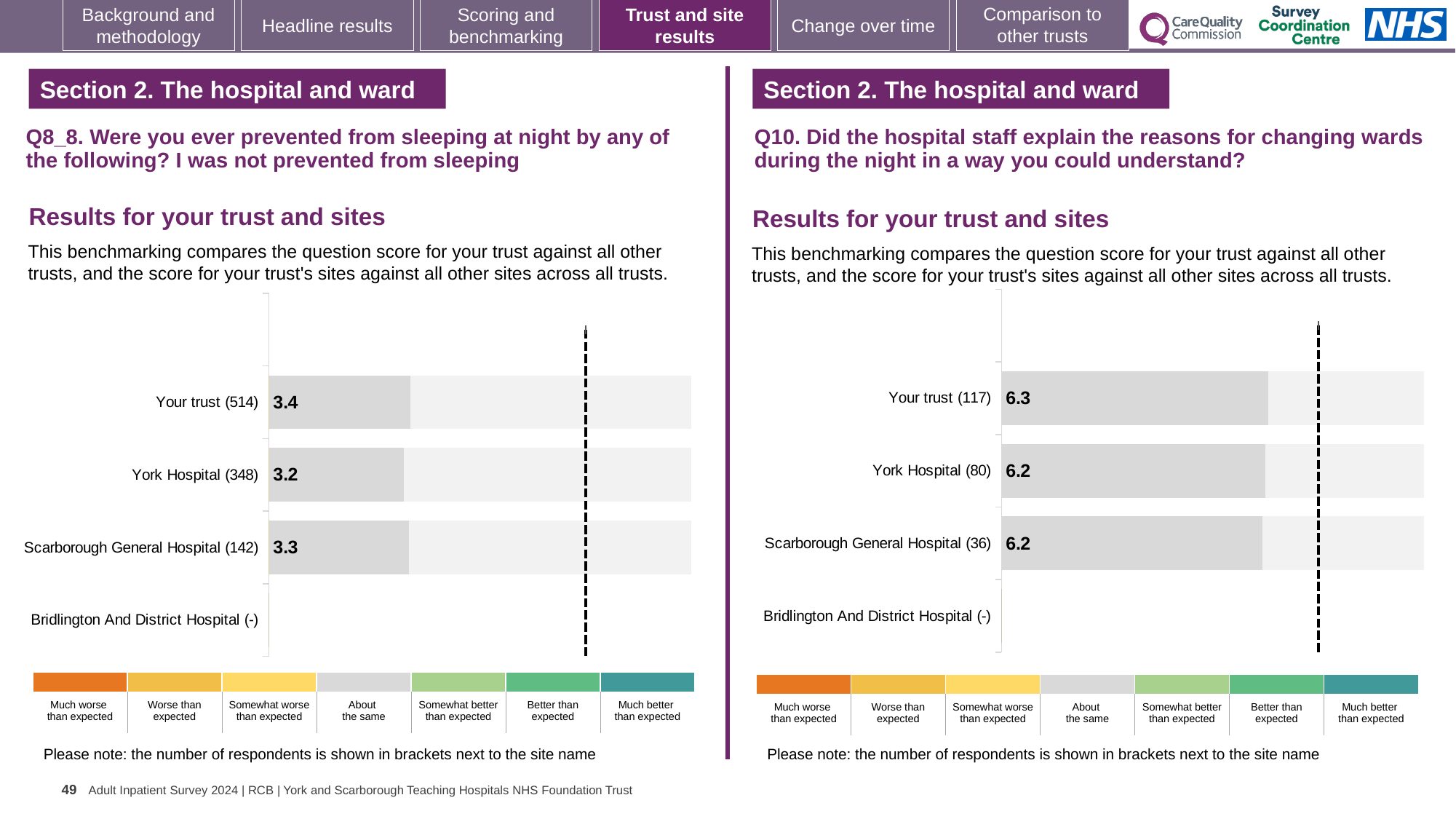
In the Q8_8 chart on the left, which site has the lowest score? York Hospital In the Q8_8 chart on the left, which site has no score shown? Bridlington And District Hospital In the Q10 chart on the right, what is the score for Scarborough General Hospital? 6.2 In the Q8_8 chart on the left, what is the score for Scarborough General Hospital? 3.3 In the Q8_8 chart on the left, what is the score for York Hospital? 3.2 In the Q10 chart on the right, what is the difference between the scores for Your trust and York Hospital? 0.1 What type of chart is used on the left side of the slide for Q8_8? Bar chart In the Q8_8 chart on the left, what is the difference between the scores for Your trust and York Hospital? 0.2 In the Q10 chart on the right, what is the score for Your trust? 6.3 In the Q8_8 chart on the left, what is the score for Your trust? 3.4 In the Q8_8 chart on the left, how many site rows are listed on the vertical axis? 4 In the Q10 chart on the right, how many respondents are shown in brackets for York Hospital? 80